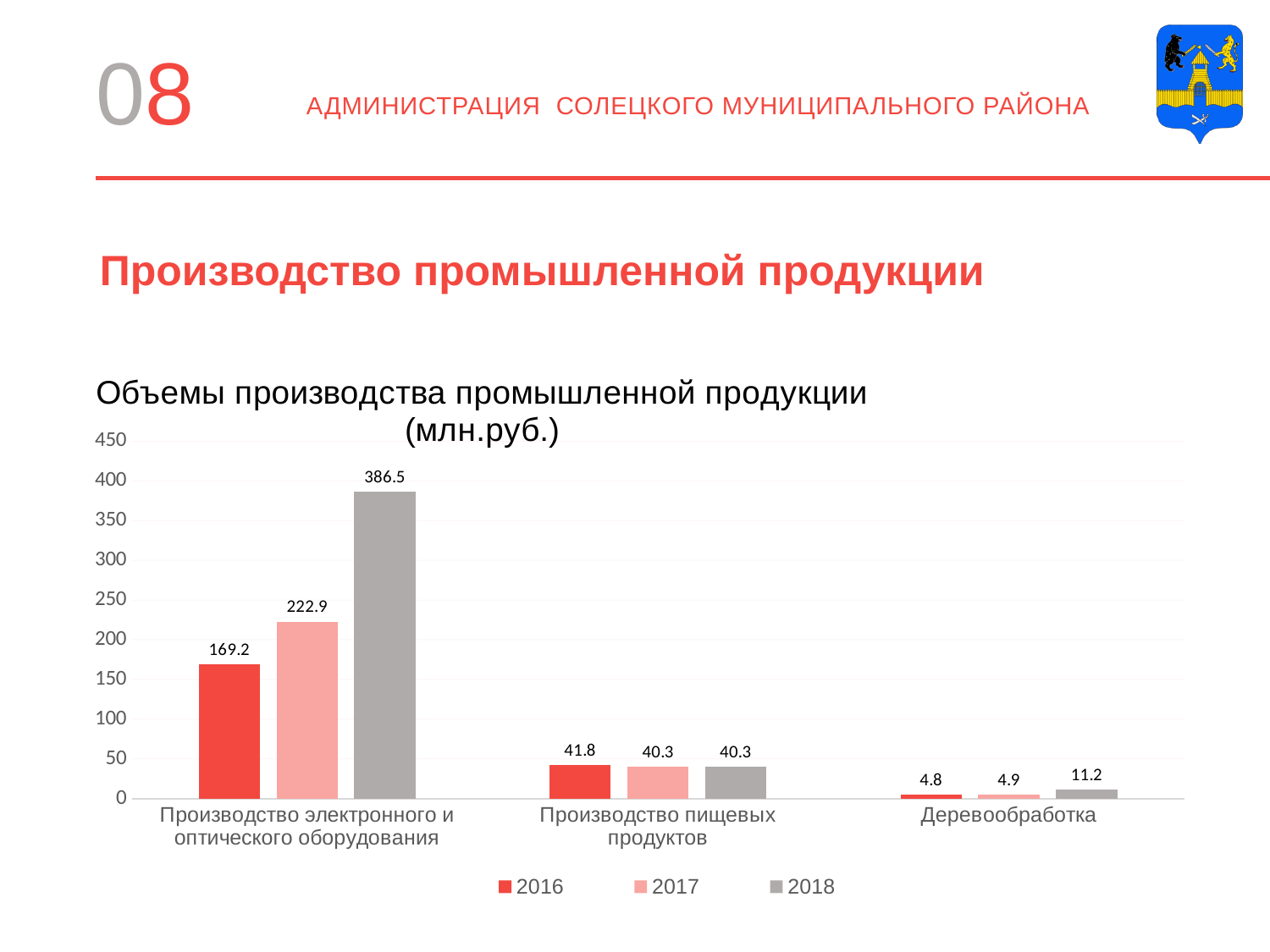
How many categories are shown on the x axis? 3 What is the value for Деревообработка in 2017? 4.9 Which is larger for Деревообработка: the 2016 value or the 2018 value? 2018 How many series does the legend list? 3 What kind of chart is shown on the slide? bar chart Is the 2017 value for Производство электронного и оптического оборудования greater or less than 200? greater What is the title of the chart? Объемы производства промышленной продукции (млн.руб.) What is the value for Производство пищевых продуктов in 2016? 41.8 Which category has the highest value in 2018? Производство электронного и оптического оборудования Which category has the lowest value in 2016? Деревообработка What is the value for Производство электронного и оптического оборудования in 2018? 386.5 What is the difference between the 2018 and 2017 values for Производство электронного и оптического оборудования? 163.6